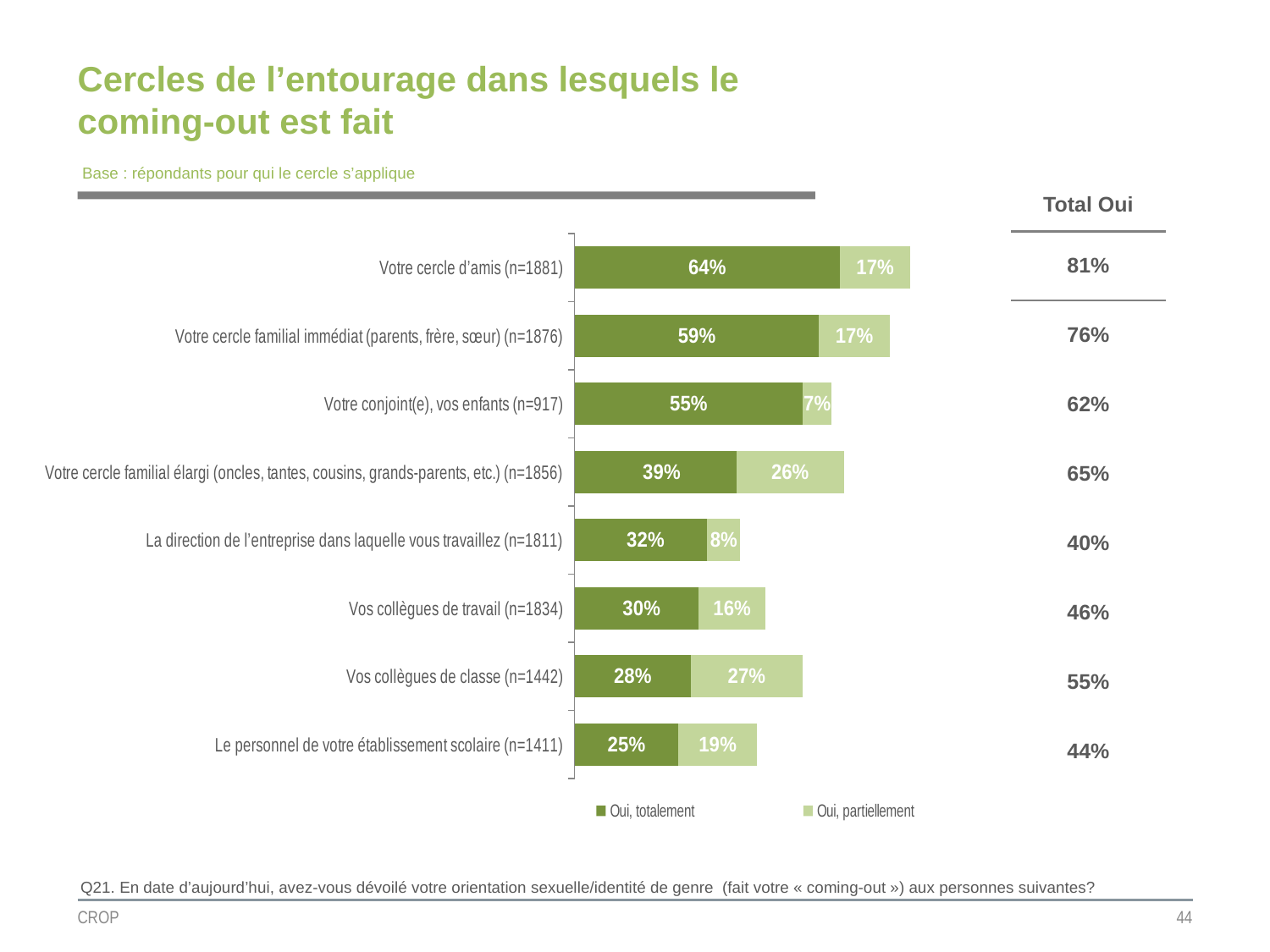
How many series does the legend list? 2 How many categories are shown in the chart? 8 What is the "Oui, totalement" value for "Le personnel de votre établissement scolaire (n=1411)"? 25% What is the difference between the "Oui, totalement" values for "Votre cercle d'amis (n=1881)" and "Vos collègues de classe (n=1442)"? 36% What are the two legend entries of the chart? Oui, totalement; Oui, partiellement What kind of chart is shown on the slide? Stacked bar chart Which category has the highest "Oui, totalement" value? Votre cercle d'amis (n=1881) What is the "Oui, totalement" value for "Votre cercle d'amis (n=1881)"? 64% Which is larger: the "Oui, partiellement" value for "Vos collègues de classe (n=1442)" or for "Vos collègues de travail (n=1834)"? Vos collègues de classe (n=1442) What is the "Oui, partiellement" value for "Votre cercle familial élargi (oncles, tantes, cousins, grands-parents, etc.) (n=1856)"? 26% What is the total of the stacked bar for "La direction de l'entreprise dans laquelle vous travaillez (n=1811)"? 40% Which category has the lowest "Oui, partiellement" value? Votre conjoint(e), vos enfants (n=917)